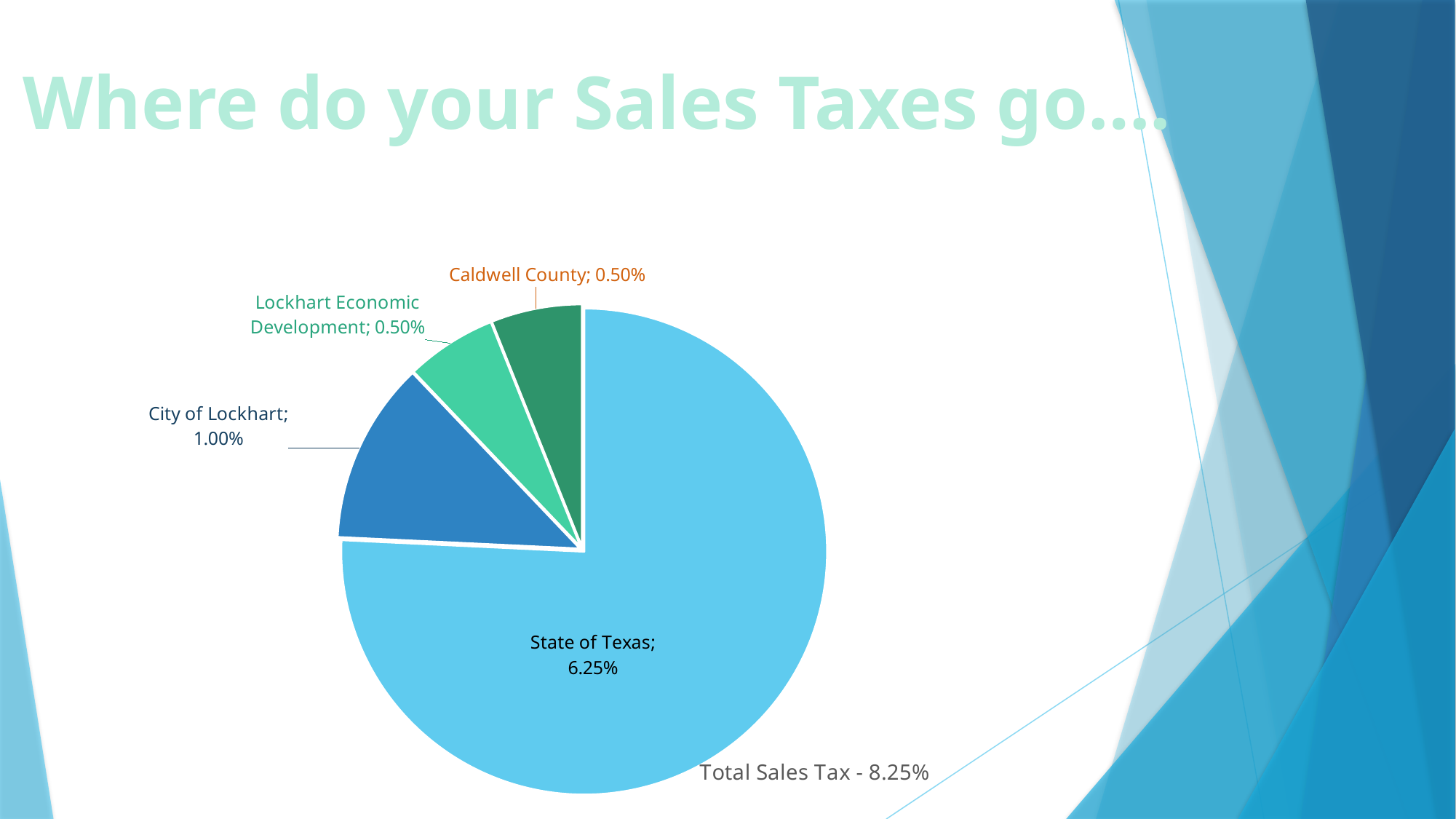
Which is larger, the value for City of Lockhart or the value for Caldwell County? City of Lockhart What is the difference between the value for City of Lockhart and the value for Lockhart Economic Development? 0.50% What is the difference between the value for State of Texas and the value for City of Lockhart? 5.25% What is the value shown for State of Texas? 6.25% What is the total sales tax shown on the slide? 8.25% What kind of chart is shown on the slide? Pie chart What is the value shown for City of Lockhart? 1.00% What is the title of the slide? Where do your Sales Taxes go.... What is the value shown for Lockhart Economic Development? 0.50% Which category has the largest slice of the pie? State of Texas What is the value shown for Caldwell County? 0.50% How many slices does the pie chart have? 4